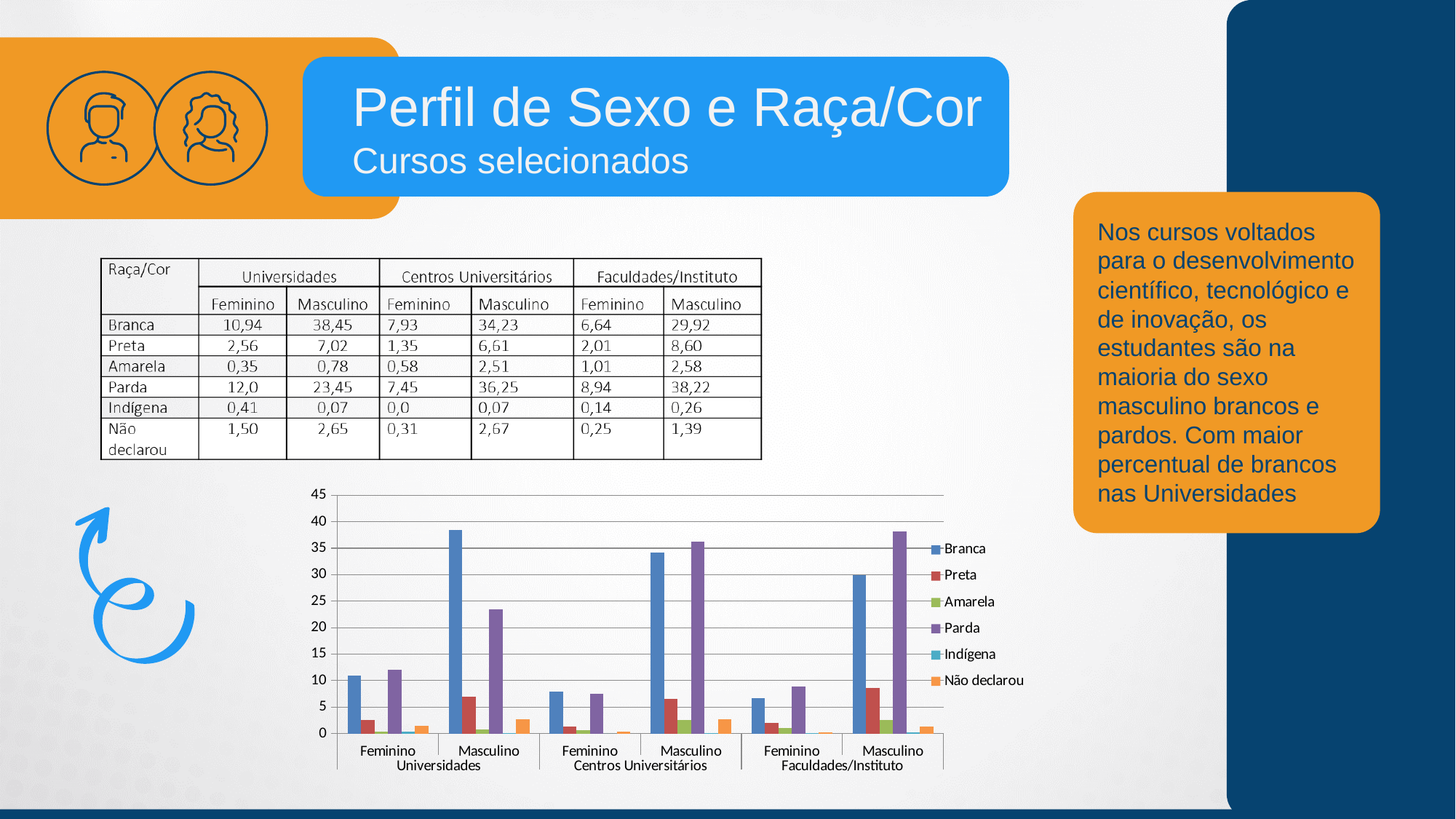
In the chart, is the Parda value for Feminino in Universidades greater or less than 10? greater Which is larger: the Parda value for Masculino in Centros Universitários or the Parda value for Masculino in Universidades? Masculino in Centros Universitários What kind of chart is shown on the slide? bar chart In the chart, is the Branca value for Masculino in Universidades greater or less than 35? greater In the chart, is the Branca value for Feminino in Centros Universitários greater or less than 10? less According to the table, what is the Parda value for Masculino in Faculdades/Instituto? 38,22 Using the table values, what is the difference between the Branca values for Masculino and Feminino in Universidades? 27,51 How many series does the chart legend list? 6 Within the Masculino Universidades group, which series has the highest bar? Branca How many category groups (sex by institution type) are shown along the x axis of the chart? 6 What colour represents the Parda series in the chart? purple According to the table, what is the Branca value for Feminino in Universidades? 10,94